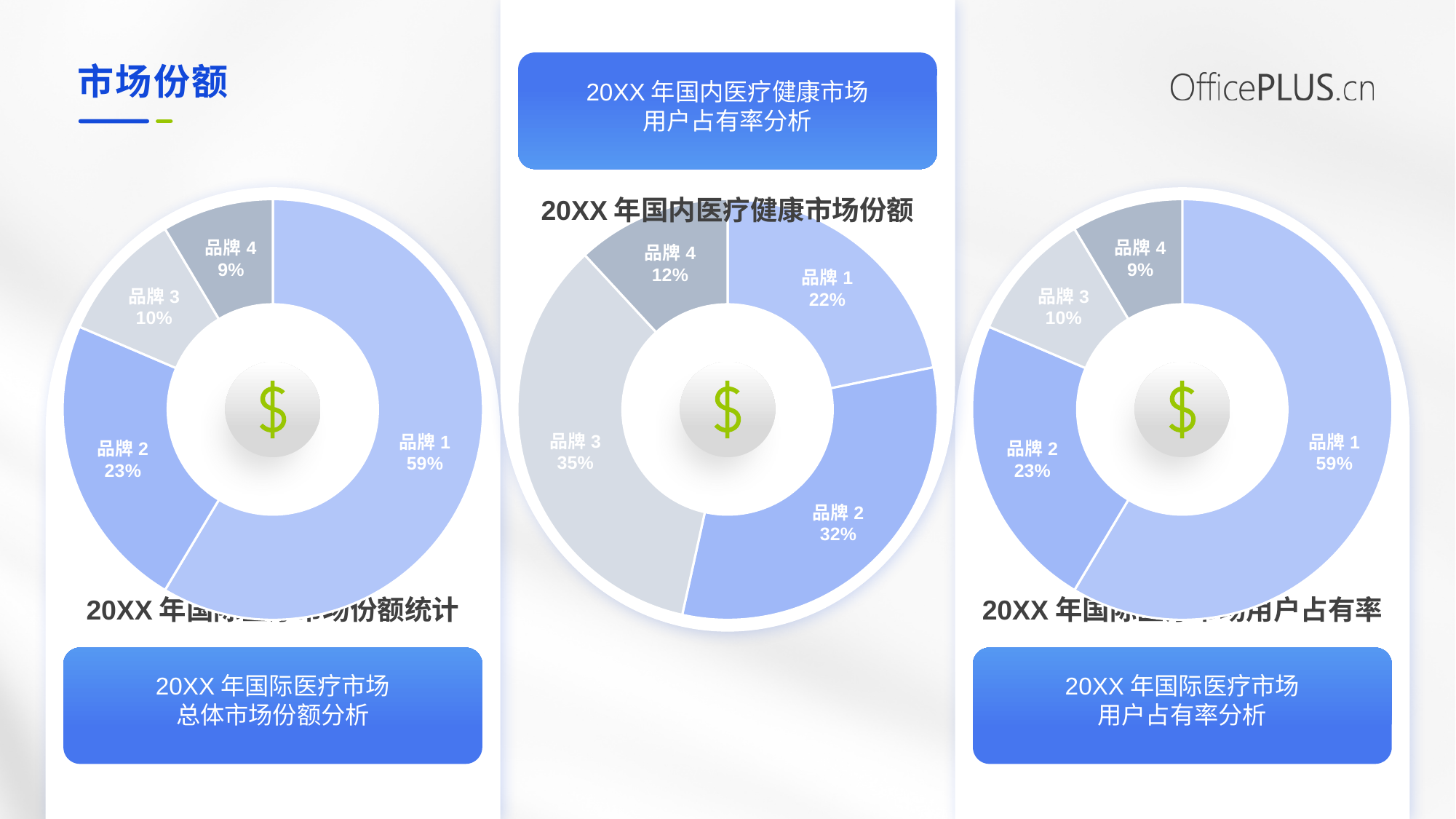
In the middle chart (20XX 年国内医疗健康市场份额), what share does 品牌 3 have? 35% How many brands (slices) are shown in the right chart? 4 In the middle chart (20XX 年国内医疗健康市场份额), what share does 品牌 1 have? 22% In the left chart, what share does 品牌 1 have? 59% In the left chart, what is the difference between the shares of 品牌 1 and 品牌 2? 36% In the middle chart (20XX 年国内医疗健康市场份额), what is the difference between the shares of 品牌 2 and 品牌 4? 20% In the right chart, which is larger, the share of 品牌 3 or 品牌 4? 品牌 3 In the right chart, what share does 品牌 2 have? 23% In the middle chart (20XX 年国内医疗健康市场份额), which brand has the largest share? 品牌 3 What type of chart is the middle chart? Doughnut (pie) chart In the left chart, which brand has the smallest share? 品牌 4 In the middle chart (20XX 年国内医疗健康市场份额), which brand has the smallest share? 品牌 4